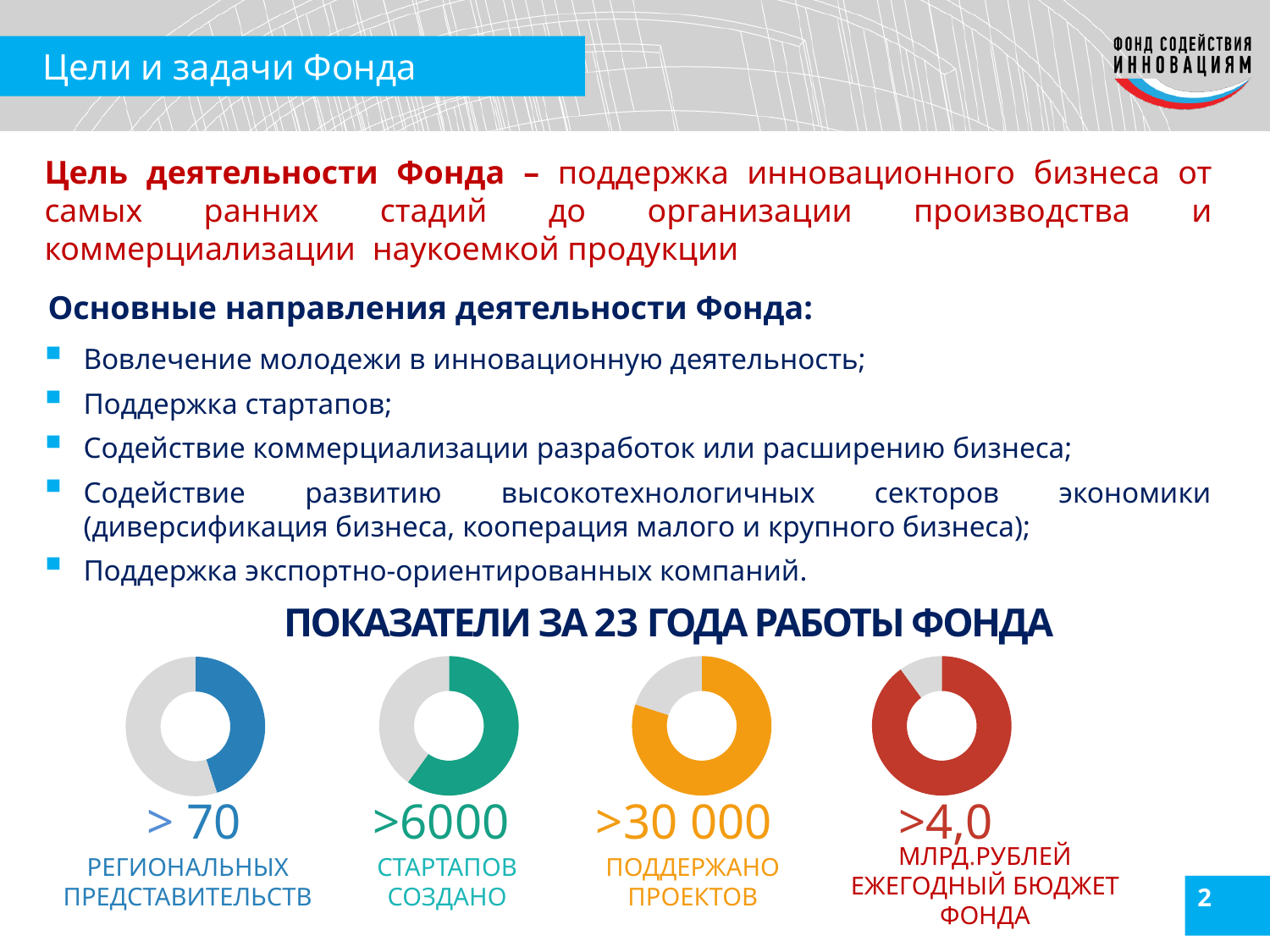
What kind of charts are shown under the heading «ПОКАЗАТЕЛИ ЗА 23 ГОДА РАБОТЫ ФОНДА»? Donut (ring) charts Is the filled portion of the blue donut chart greater or less than 50% of the ring? less What is the heading above the four donut charts? ПОКАЗАТЕЛИ ЗА 23 ГОДА РАБОТЫ ФОНДА Which of the four donut charts has the smallest filled (coloured) portion of its ring? The blue one (региональных представительств) What figure is printed under the blue donut chart for «РЕГИОНАЛЬНЫХ ПРЕДСТАВИТЕЛЬСТВ»? > 70 What figure is printed under the red donut chart for «ЕЖЕГОДНЫЙ БЮДЖЕТ ФОНДА»? >4,0 МЛРД.РУБЛЕЙ What figure is printed under the green donut chart for «СТАРТАПОВ СОЗДАНО»? >6000 What colour is the donut chart for «ПОДДЕРЖАНО ПРОЕКТОВ»? Orange How many donut charts are shown on the slide? 4 Which donut has a larger filled portion: the blue one for региональных представительств or the red one for ежегодный бюджет фонда? The red one What figure is printed under the orange donut chart for «ПОДДЕРЖАНО ПРОЕКТОВ»? >30 000 Which of the four donut charts has the largest filled (coloured) portion of its ring? The red one (ежегодный бюджет фонда)